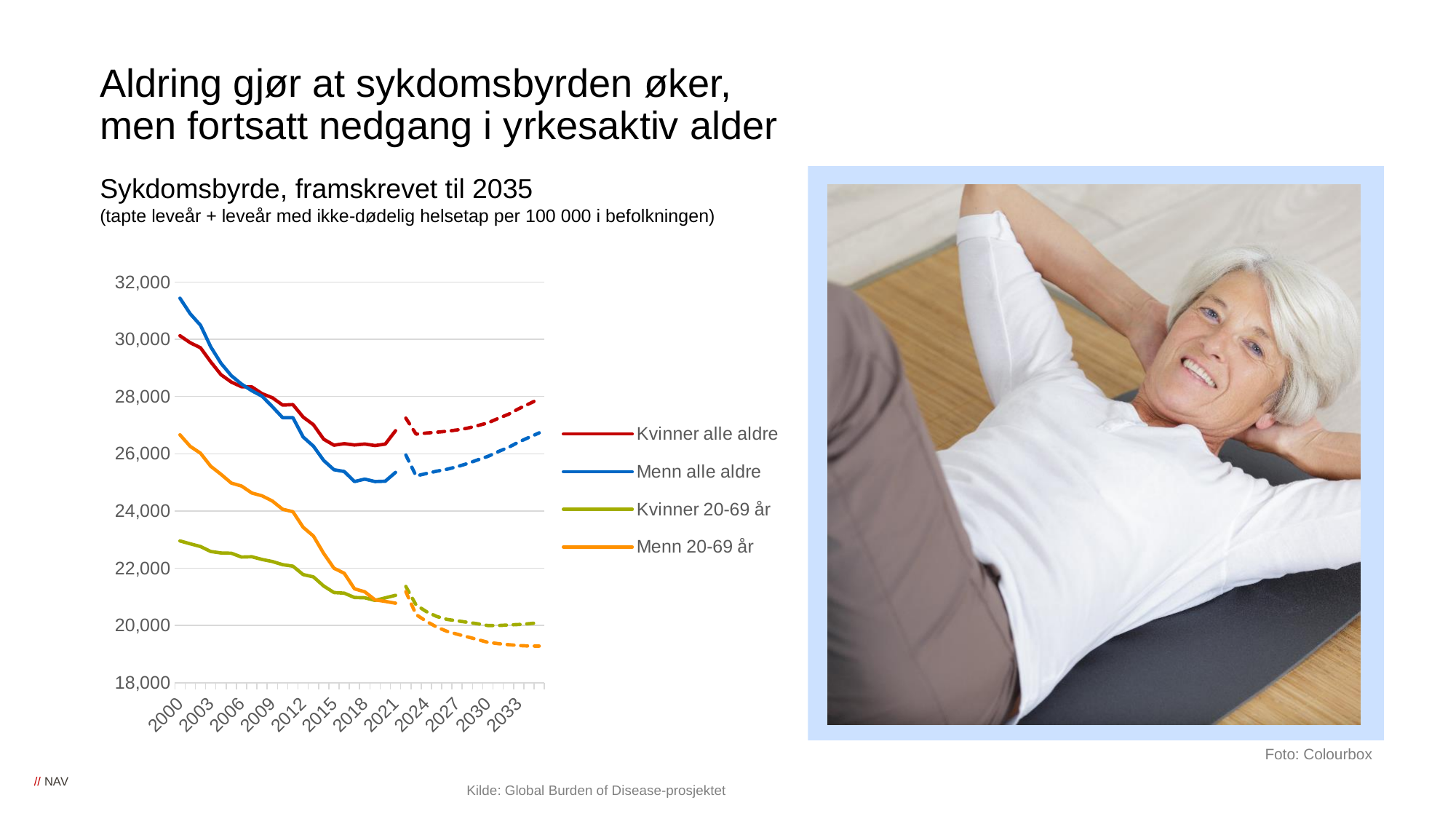
Does the Menn 20-69 år series rise or fall from 2000 to 2035? Fall Which series has the highest value in 2000? Menn alle aldre Is the value for Kvinner 20-69 år in 2000 greater or less than 24,000? less How many series does the chart legend list? 4 Which series has the lowest value in 2035? Menn 20-69 år Is the value for Menn alle aldre in 2035 greater or less than 26,000? greater Is the value for Menn alle aldre in 2000 greater or less than 30,000? greater What kind of chart is shown on the slide? Line chart What is the title of the chart? Sykdomsbyrde, framskrevet til 2035 In 2035, which is higher: Kvinner alle aldre or Menn alle aldre? Kvinner alle aldre Does the Kvinner alle aldre series rise or fall over the projected (dashed) period from about 2022 to 2035? Rise